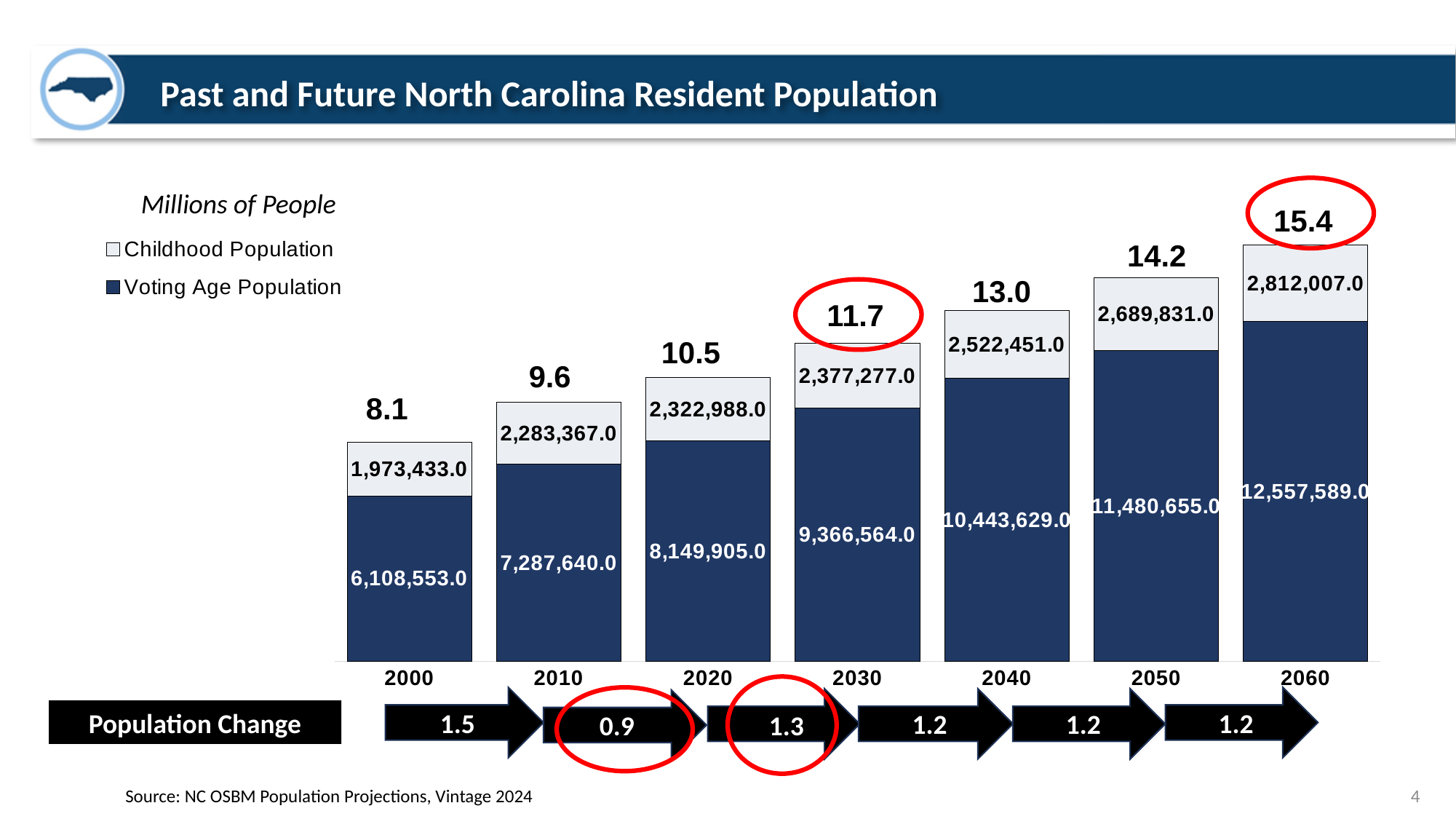
What is the Childhood Population for 2060? 2,812,007.0 Do the total populations rise or fall from 2000 to 2060? Rise Which year has the lowest Childhood Population? 2000 What is the total population in millions for 2040? 13.0 What total population in millions is shown above the 2030 bar? 11.7 How many years are shown on the x axis? 7 Is the Childhood Population larger in 2020 or in 2010? 2020 Which year has the highest total population? 2060 What is the Voting Age Population for 2000? 6,108,553.0 How many series does the legend list? 2 What kind of chart is shown on the slide? Stacked bar chart What is the difference between the Voting Age Population in 2060 and in 2000? 6,449,036.0